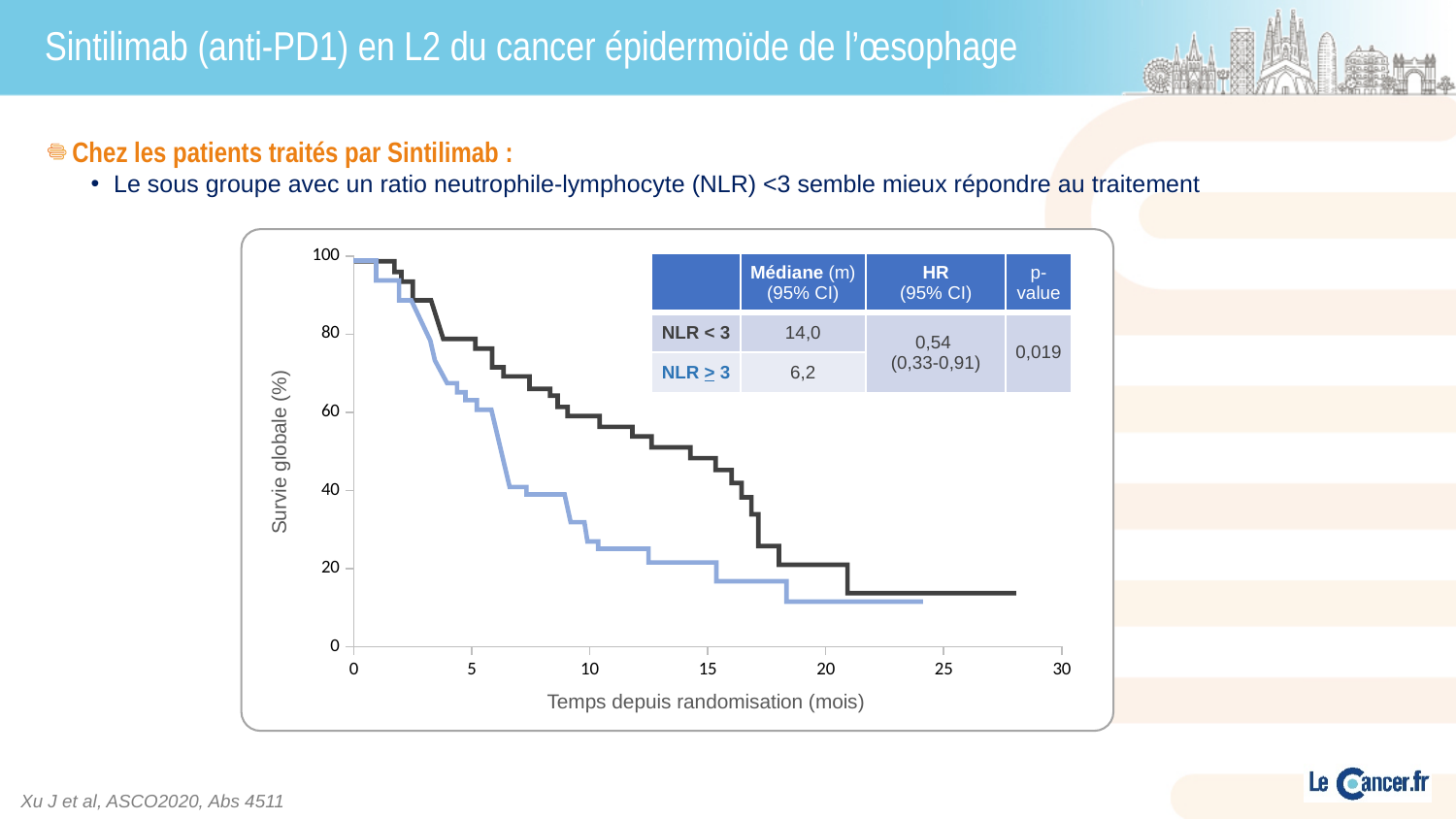
According to the table on the chart, what is the median survival (m) for the NLR ≥ 3 group? 6,2 Do the curves rise or fall as time since randomisation increases? Fall At 10 months, is the value of the blue curve greater or less than 40? less What is the label of the x axis of the chart? Temps depuis randomisation (mois) What is the label of the y axis of the chart? Survie globale (%) At 15 months, which curve is higher, the black one or the blue one? The black curve At 10 months, is the value of the black curve greater or less than 40? greater What is the difference in median survival (m) between the NLR < 3 and NLR ≥ 3 groups shown in the table? 7,8 How many curves are plotted on the chart? 2 At 20 months, is the value of the blue curve greater or less than 20? less What kind of chart is shown on the slide? Line chart (survival curve) According to the table on the chart, what is the median survival (m) for the NLR < 3 group? 14,0